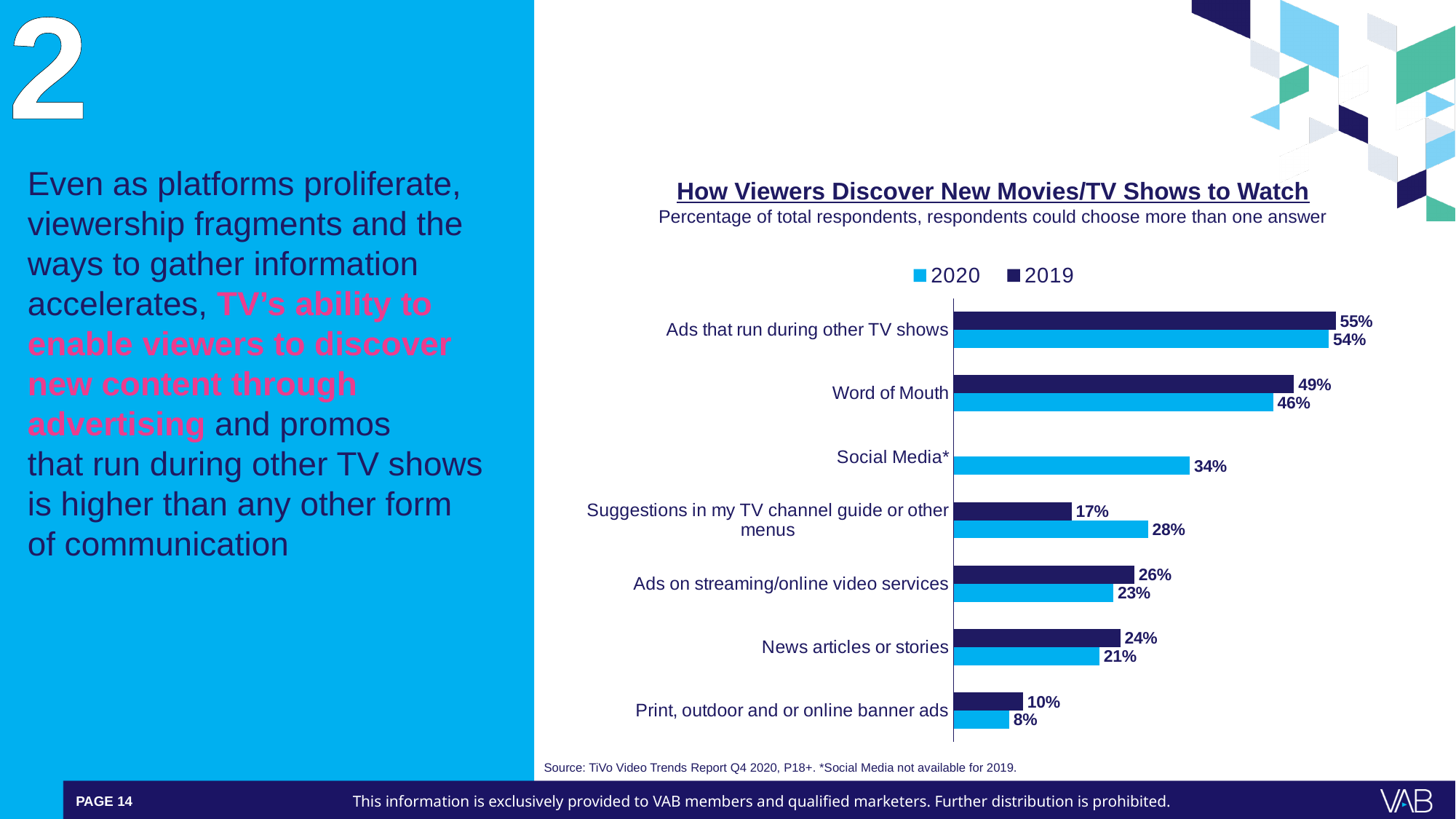
What is the title of the chart? How Viewers Discover New Movies/TV Shows to Watch What is the 2019 value for Suggestions in my TV channel guide or other menus? 17% What kind of chart is shown on the slide? Bar chart How many series does the legend list? 2 What is the 2020 value for Word of Mouth? 46% Which category has the highest 2020 value? Ads that run during other TV shows For Suggestions in my TV channel guide or other menus, which year has the larger value, 2020 or 2019? 2020 What is the difference between the 2019 and 2020 values for Ads on streaming/online video services? 3% How many categories are shown on the chart? 7 What is the 2020 value for Social Media*? 34% What is the 2019 value for News articles or stories? 24% Which category has the lowest 2019 value? Print, outdoor and or online banner ads